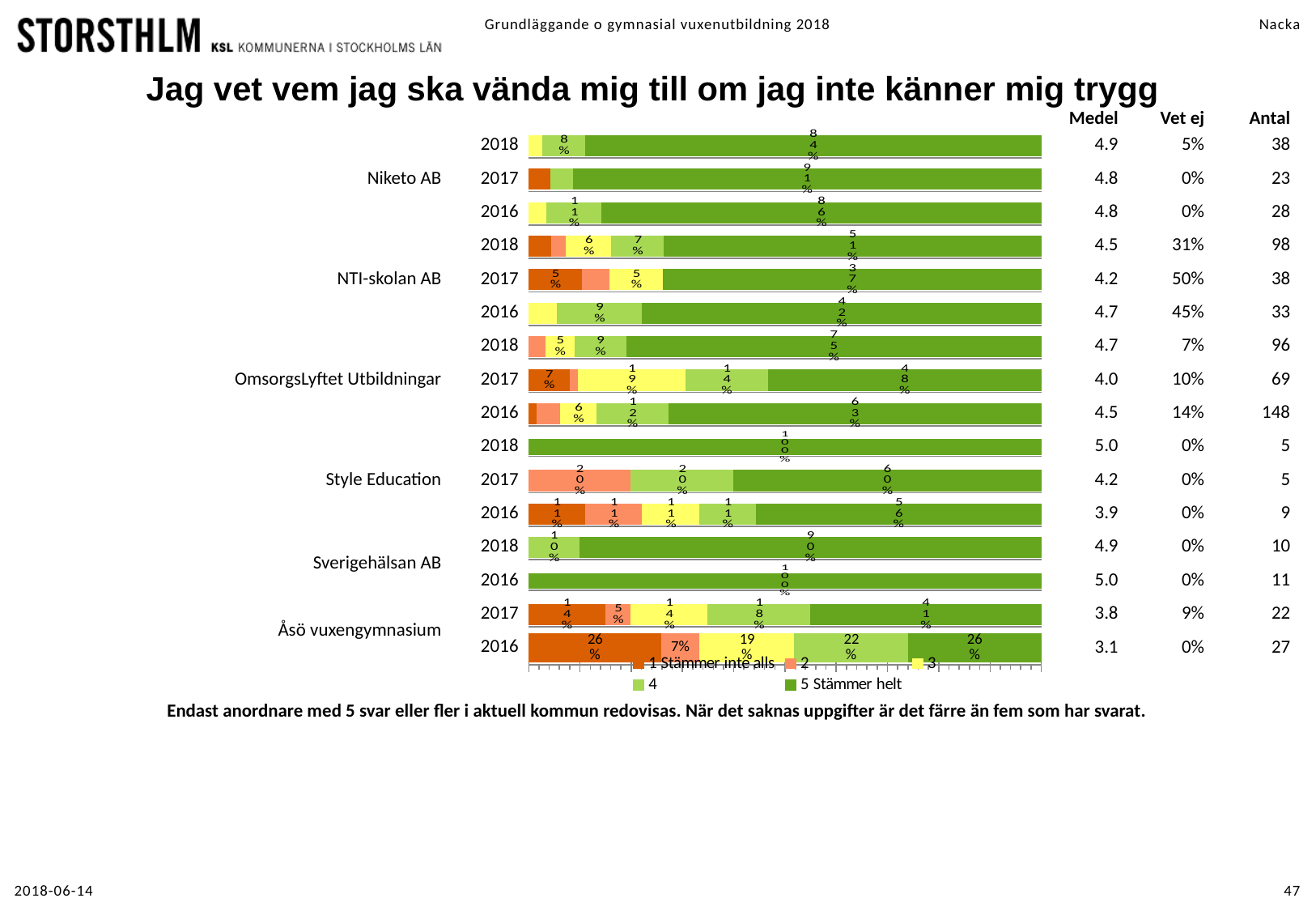
What kind of chart is shown on the slide? Stacked bar chart What is the '3' share for OmsorgsLyftet Utbildningar in 2017? 19% How many series does the chart legend list? 5 What is the total of the stacked bar for Åsö vuxengymnasium in 2016? 100% What is the first legend entry of the chart? 1 Stämmer inte alls What is the '5 Stämmer helt' share for Style Education in 2018? 100% Which is larger: the '1 Stämmer inte alls' share for Åsö vuxengymnasium in 2016 or in 2017? 2016 What is the difference between the '1 Stämmer inte alls' share (26%) and the '2' share (7%) for Åsö vuxengymnasium in 2016? 19 percentage points Which bar has the lowest '5 Stämmer helt' share? Åsö vuxengymnasium 2016 What is the '4' share for Sverigehälsan AB in 2018? 10% What is the '1 Stämmer inte alls' share for Åsö vuxengymnasium in 2016? 26% What is the '5 Stämmer helt' share for Niketo AB in 2017? 91%